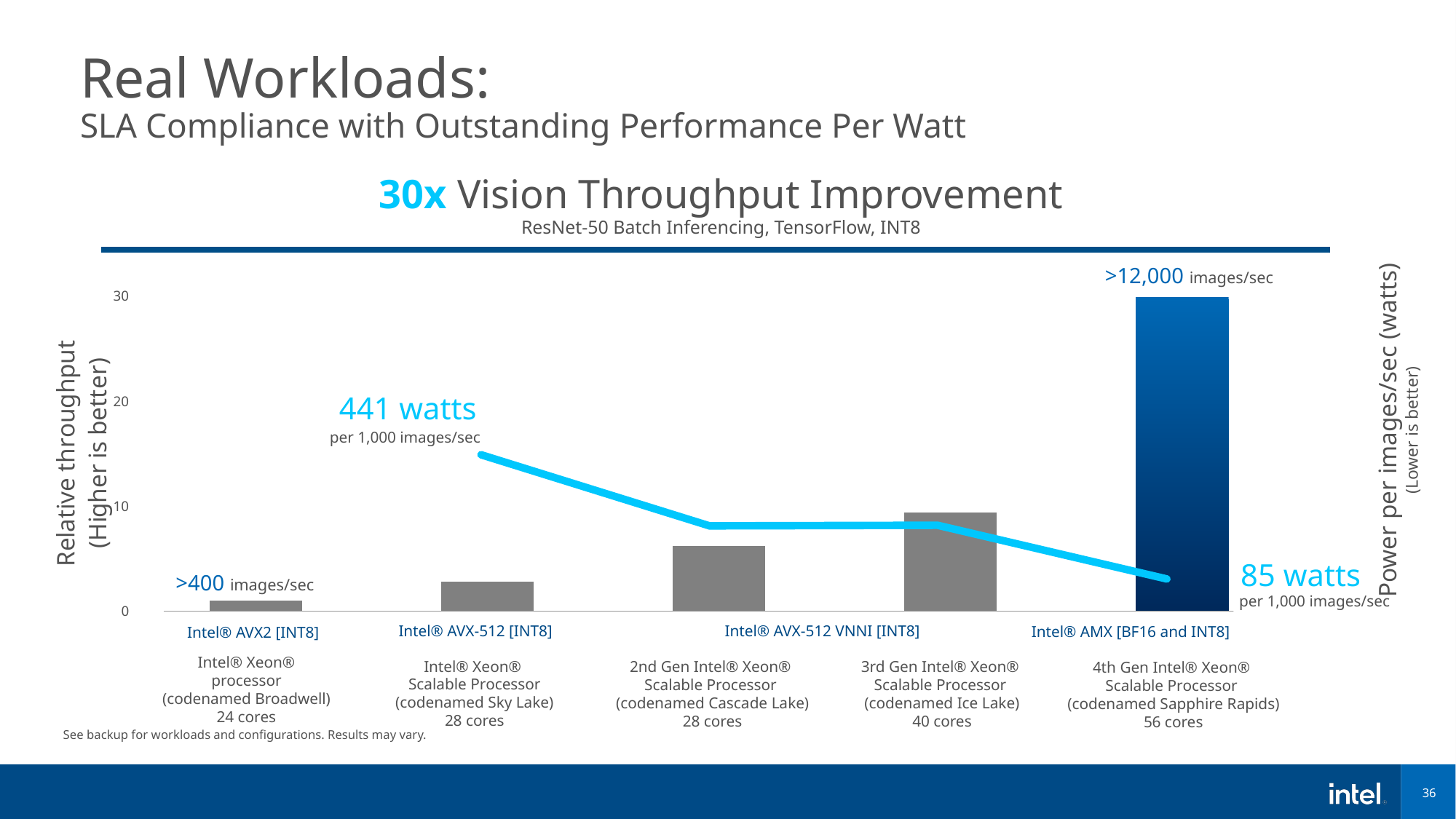
What kind of chart is used to show relative throughput on this slide? bar chart How many processor generations (bars) are plotted in the chart? 5 Is the relative throughput bar for Cascade Lake (2nd Gen Intel Xeon Scalable Processor) greater or less than 10? less What throughput in images/sec is labelled above the Sapphire Rapids bar? >12,000 images/sec What is the power per 1,000 images/sec labelled for the Sapphire Rapids (Intel AMX) point? 85 watts Do the relative throughput bars rise or fall from Broadwell to Sapphire Rapids? rise What is the difference in watts per 1,000 images/sec between the Sky Lake point (441 watts) and the Sapphire Rapids point (85 watts)? 356 watts Which has the larger relative throughput bar, Ice Lake or Cascade Lake? Ice Lake What is the power per 1,000 images/sec labelled for the Sky Lake (Intel AVX-512) point? 441 watts Which processor has the lowest relative throughput bar? Intel Xeon processor (codenamed Broadwell) Does the power per images/sec line rise or fall from Sky Lake to Sapphire Rapids? fall Which processor has the highest relative throughput bar? 4th Gen Intel Xeon Scalable Processor (codenamed Sapphire Rapids)